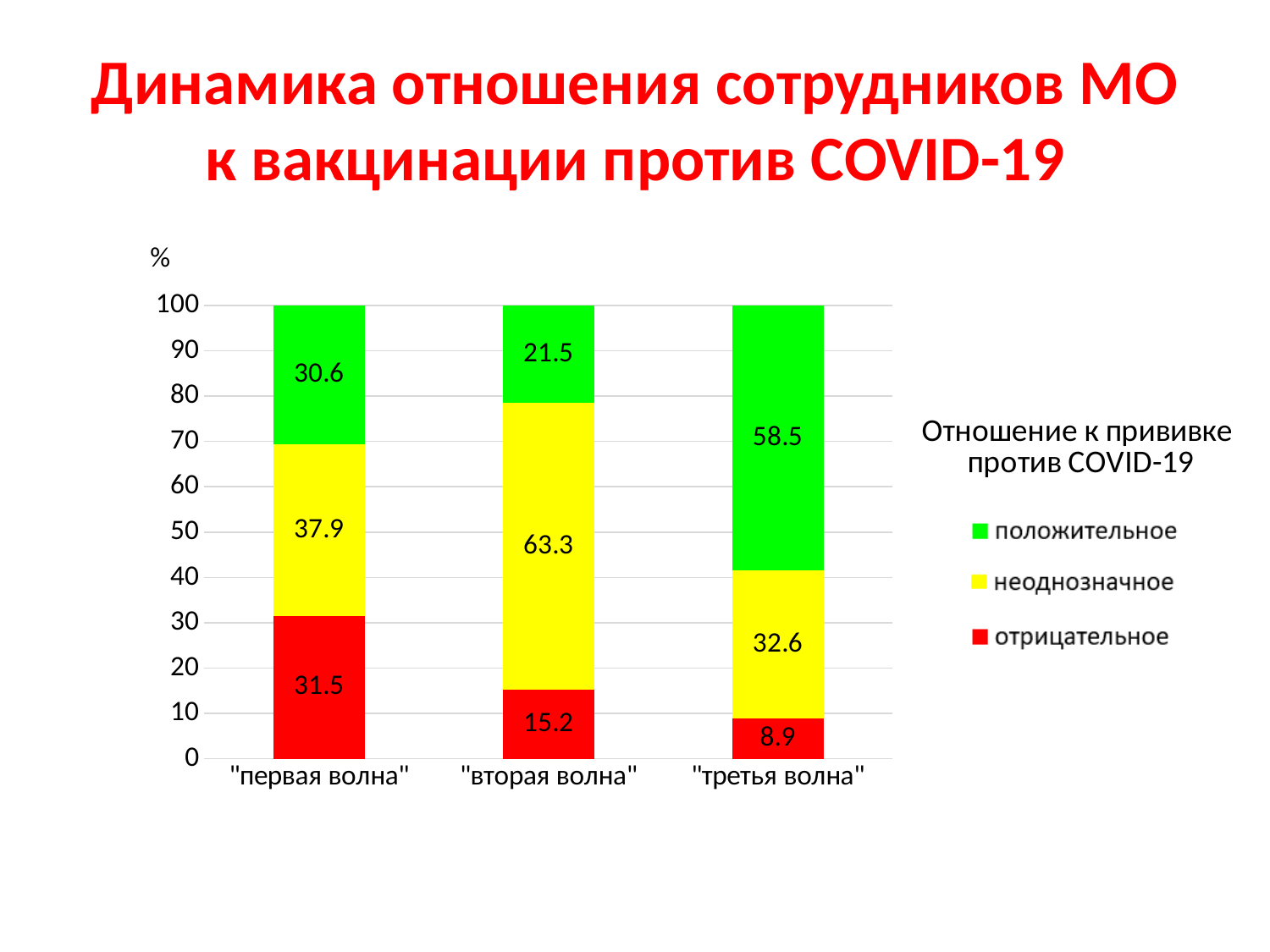
What kind of chart is shown on the slide? stacked bar chart Which is larger: the "отрицательное" value for "вторая волна" or for "третья волна"? "вторая волна" Does the "отрицательное" value rise or fall from "первая волна" to "третья волна"? fall How many categories are shown on the x axis? 3 How many series does the legend list? 3 What is the value for "положительное" in "третья волна"? 58.5 What is the value for "неоднозначное" in "вторая волна"? 63.3 What is the difference between the "положительное" values for "третья волна" and "первая волна"? 27.9 Which colour represents "неоднозначное" in the chart? yellow In which category is the "отрицательное" value lowest? "третья волна" In which category is the "положительное" value highest? "третья волна" What is the value for "отрицательное" in "первая волна"? 31.5